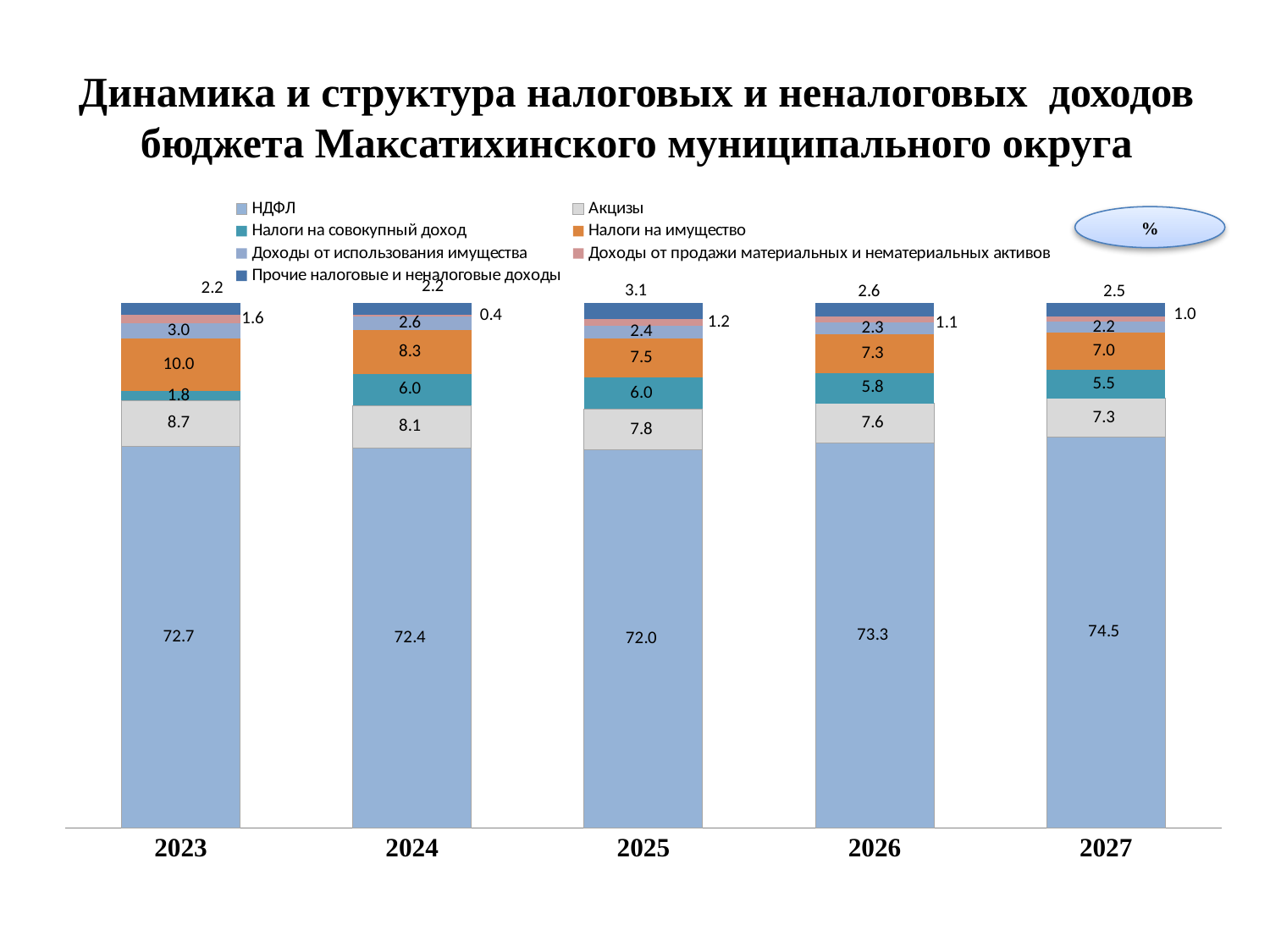
What type of chart is shown on the slide? stacked bar chart Which is larger: Акцизы in 2024 or Акцизы in 2026? Акцизы in 2024 What is the value of Налоги на имущество for 2023? 10.0 What is the value of Акцизы for 2025? 7.8 How many years are shown on the x axis? 5 How many series does the legend list? 7 What is the difference between the Налоги на имущество values for 2023 and 2027? 3.0 In which year is the Налоги на совокупный доход value the lowest? 2023 What is the value of НДФЛ for 2027? 74.5 In which year is the НДФЛ value the highest? 2027 Do the Акцизы values rise or fall from 2023 to 2027? fall What is the total of the stacked bar for 2024? 100.0